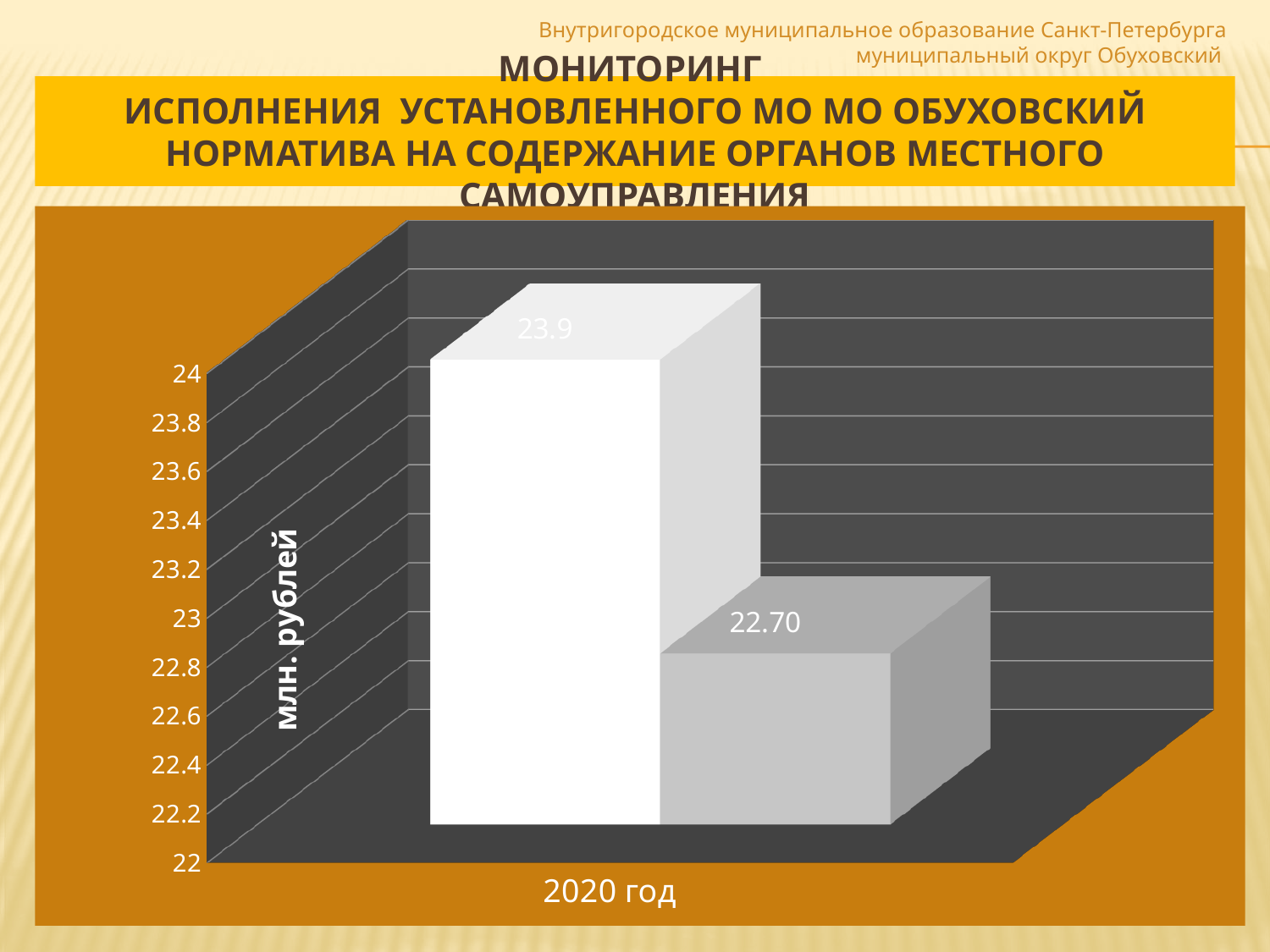
What value is printed on the grey (right) bar for 2020 год? 22.70 Is the value of the grey (right) bar larger or smaller than the value of the white (left) bar? smaller Which bar is the tallest, the white (left) bar or the grey (right) bar? the white (left) bar Is the value for the grey (right) bar greater or less than 23? less Is the value for the white (left) bar greater or less than 23.5? greater What is the difference between the white bar value (23.9) and the grey bar value (22.70)? 1.2 What is the label of the vertical axis of the chart? млн. рублей What kind of chart is shown on the slide? bar chart How many categories are shown on the x axis of the chart? 1 How many bars are plotted in the chart? 2 Which bar is the lowest, the white (left) bar or the grey (right) bar? the grey (right) bar What value is printed on the white (left) bar for 2020 год? 23.9